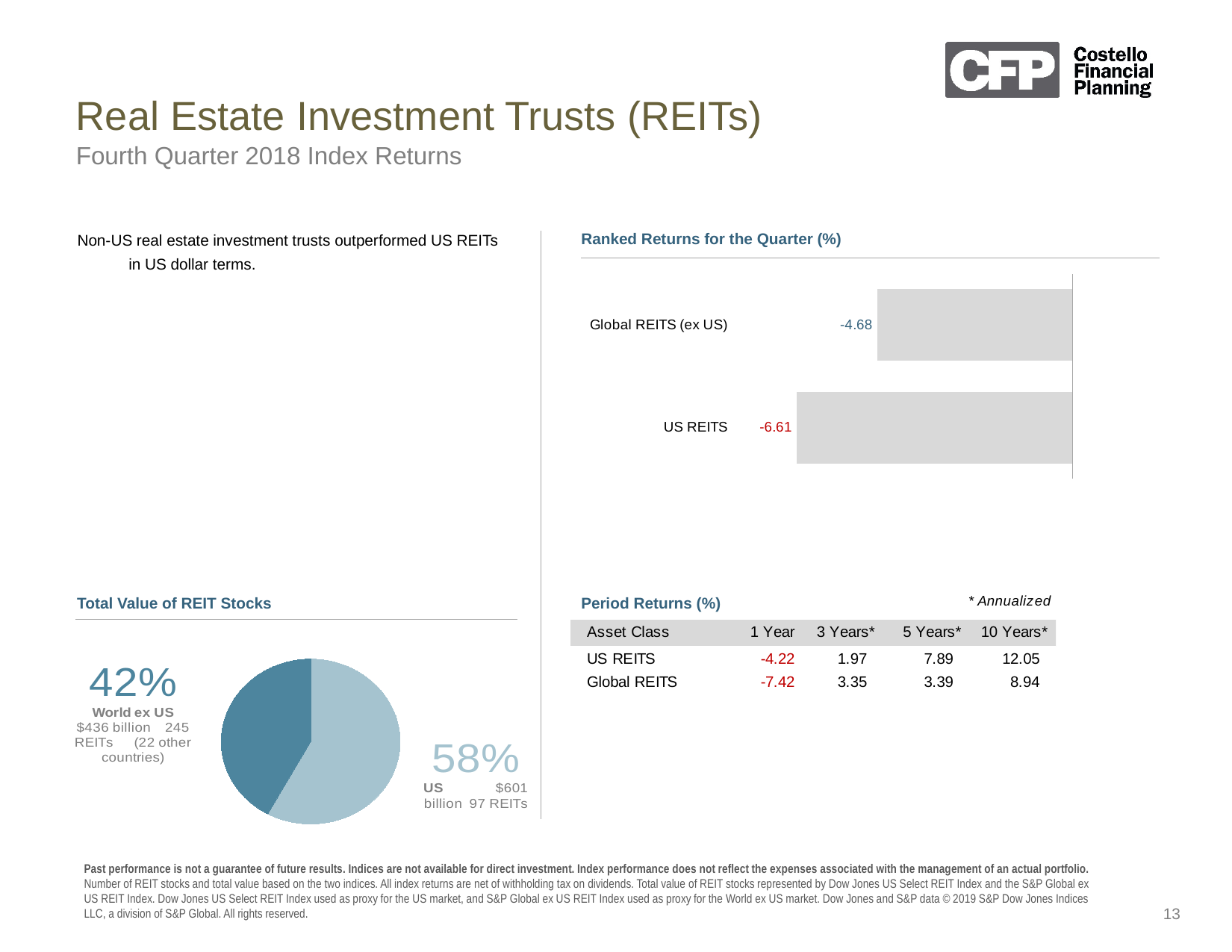
In the Ranked Returns for the Quarter (%) chart, what is the value for US REITS? -6.61 What kind of chart is the Total Value of REIT Stocks chart? Pie chart What kind of chart is the Ranked Returns for the Quarter (%) chart? Bar chart In the Ranked Returns for the Quarter (%) chart, what is the value for Global REITS (ex US)? -4.68 In the Total Value of REIT Stocks chart, which slice is larger, US or World ex US? US In the Ranked Returns for the Quarter (%) chart, which is larger, the value for Global REITS (ex US) or US REITS? Global REITS (ex US) In the Total Value of REIT Stocks chart, what share of the pie is US? 58% In the Ranked Returns for the Quarter (%) chart, what is the difference between the Global REITS (ex US) and US REITS values? 1.93 In the Ranked Returns for the Quarter (%) chart, which category has the highest return? Global REITS (ex US) In the Total Value of REIT Stocks chart, what share of the pie is World ex US? 42% In the Ranked Returns for the Quarter (%) chart, which category has the lowest return? US REITS How many categories are shown in the Ranked Returns for the Quarter (%) chart? 2